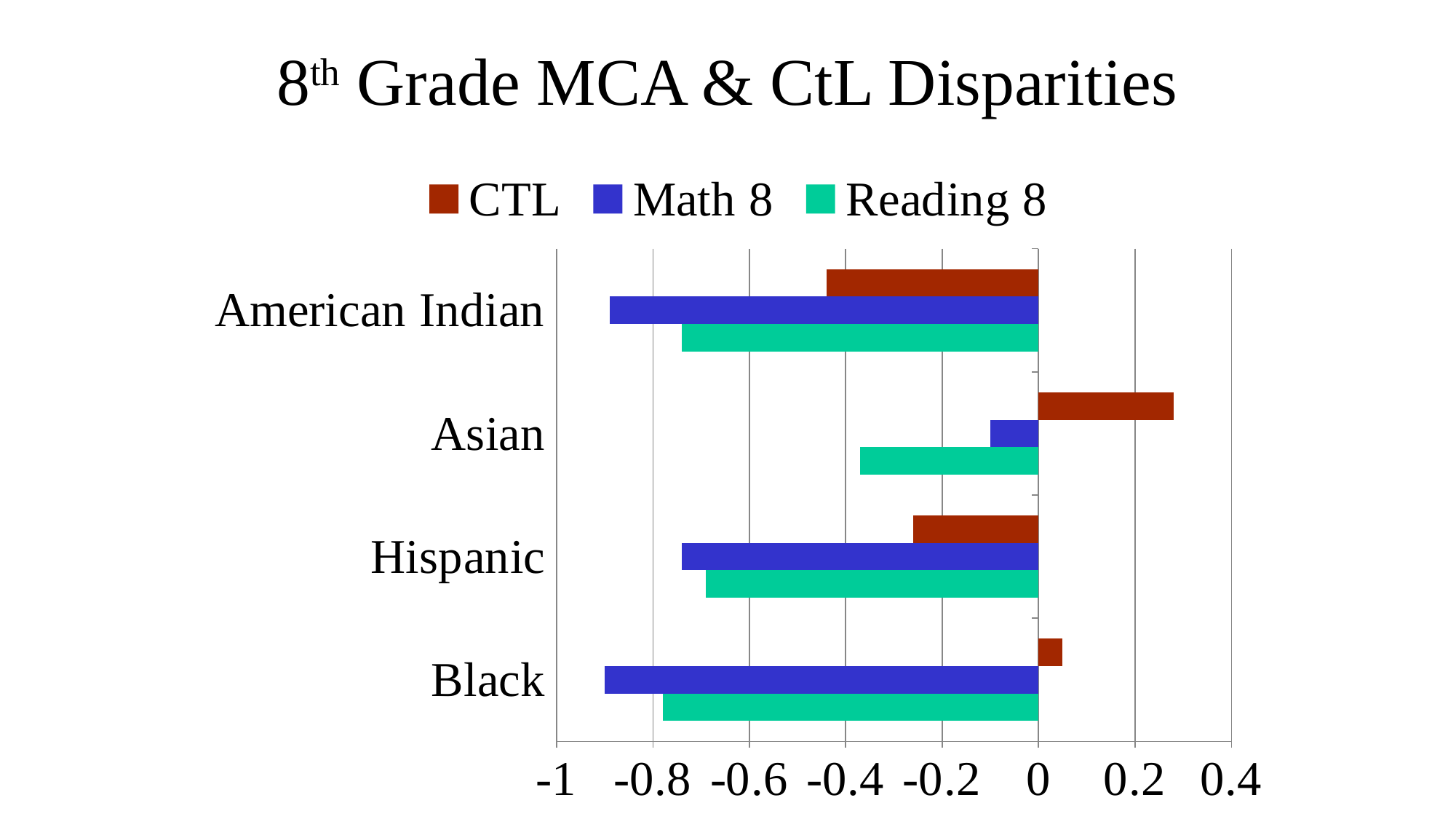
Which category has the highest Reading 8 value? Asian Which is larger, the CTL value for Asian or the CTL value for Black? Asian Is the Reading 8 value for Black greater or less than -0.6? less What kind of chart is shown on the slide? bar chart What is the title of the chart? 8th Grade MCA & CtL Disparities Which category has the highest CTL value? Asian Which series is shown in blue in the legend? Math 8 How many series does the legend list? 3 Is the CTL value for Asian greater or less than 0.2? greater Is the Math 8 value for American Indian greater or less than -0.8? less How many categories (racial/ethnic groups) are shown on the chart? 4 Which category has the highest Math 8 value? Asian